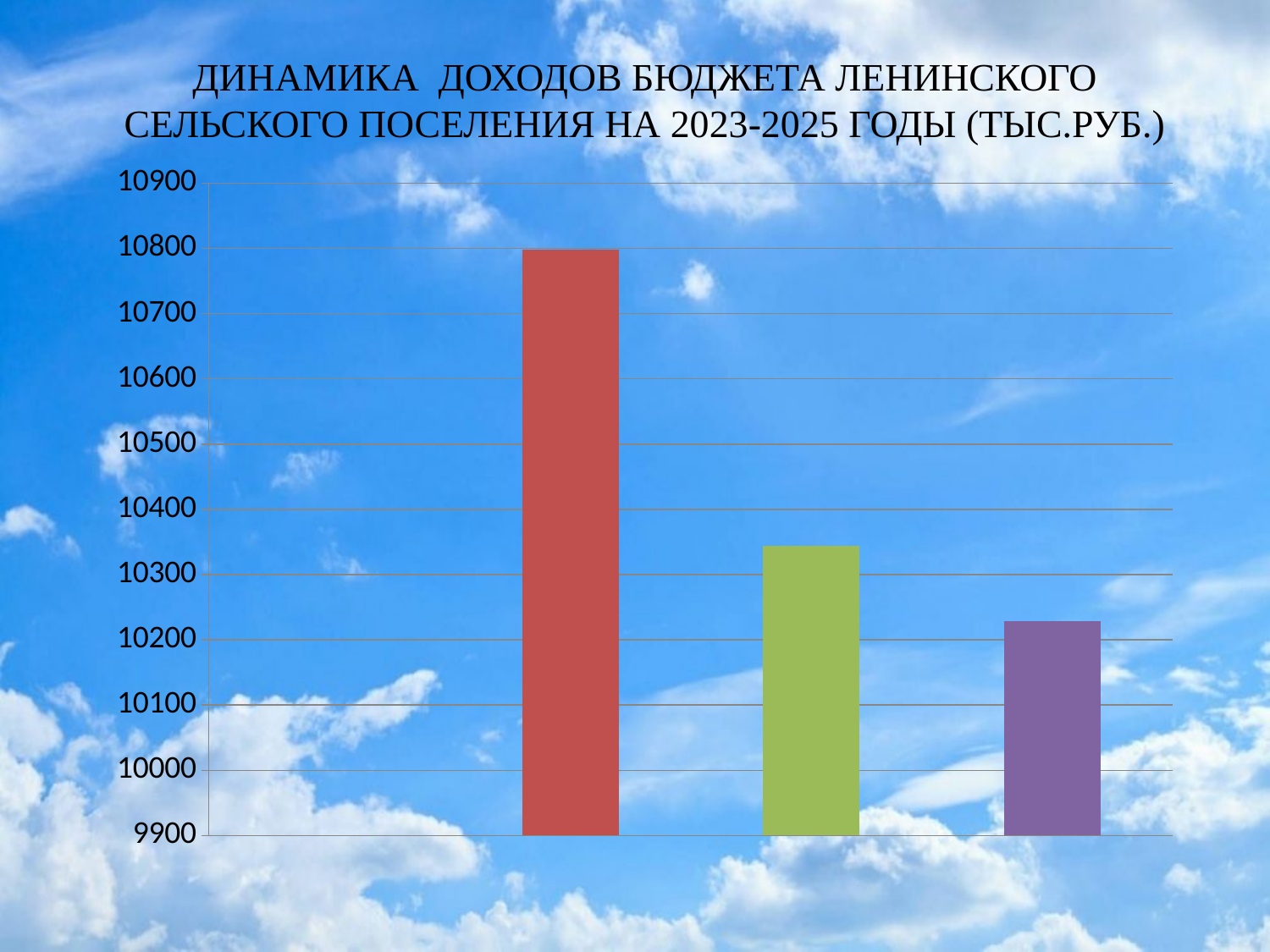
Which bar is the shortest: the red, the green or the purple one? purple How many bars are plotted in the chart? 3 What kind of chart is shown on the slide? bar chart Is the value of the purple (rightmost) bar greater or less than 10200? greater Is the value of the green (middle) bar greater or less than 10400? less Which is larger, the value of the green bar or the value of the purple bar? green bar Do the bar values rise or fall from left to right across the chart? fall What is the highest value shown on the vertical axis? 10900 Is the value of the green (middle) bar greater or less than 10300? greater Which bar is the tallest: the red, the green or the purple one? red In what units are the values given according to the chart title? тыс.руб.